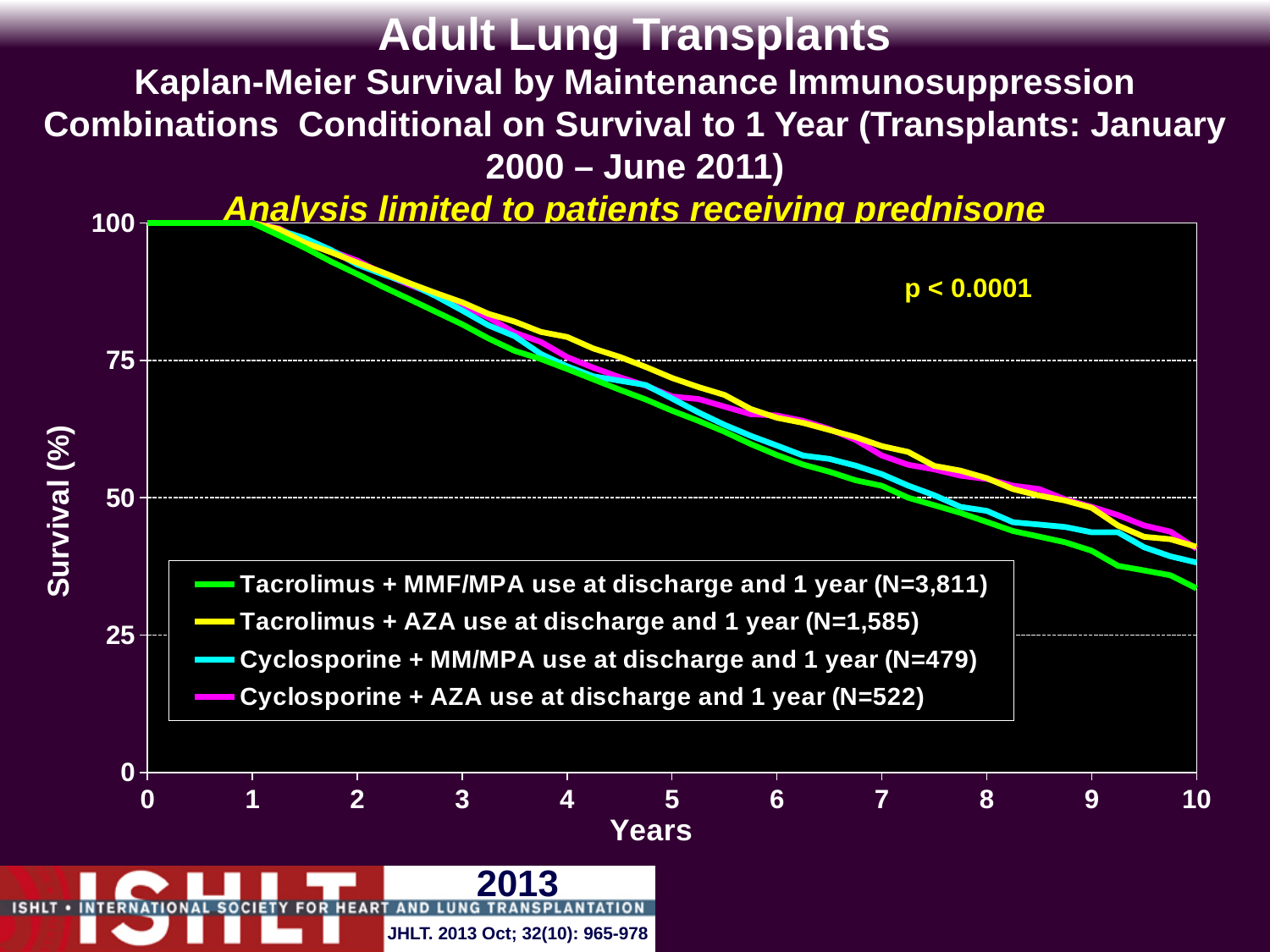
Is the survival for Tacrolimus + MMF/MPA use at discharge and 1 year at 10 years greater or less than 50? less Is the survival for Cyclosporine + MM/MPA use at discharge and 1 year at 2 years greater or less than 75? greater What is the N for the Tacrolimus + MMF/MPA use at discharge and 1 year group in the legend? 3,811 At 10 years, which group has higher survival: Tacrolimus + AZA or Tacrolimus + MMF/MPA? Tacrolimus + AZA What p-value is shown on the chart? p < 0.0001 What kind of chart is shown on the slide? Line chart Is the survival for Tacrolimus + AZA use at discharge and 1 year at 3 years greater or less than 75? greater Which group has the lowest survival at 10 years? Tacrolimus + MMF/MPA use at discharge and 1 year What is the survival (%) for all four groups at 1 year? 100 How many series does the legend list? 4 Do the survival curves rise or fall as the years increase along the x axis? Fall